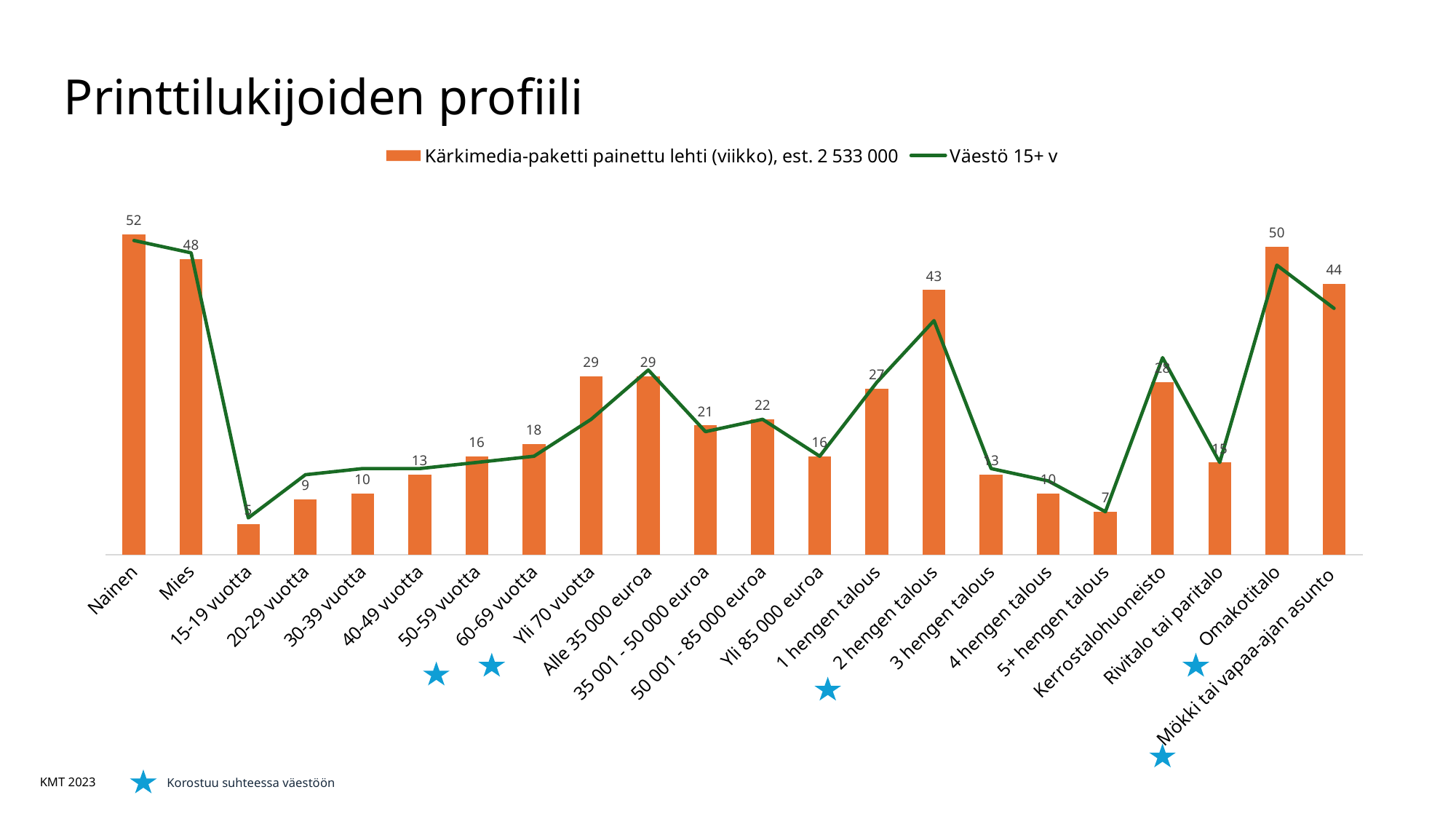
What is the value of the orange bar for 35 001 - 50 000 euroa? 21 How many categories are shown on the x axis? 22 What does the green line in the chart represent according to the legend? Väestö 15+ v What is the value of the orange bar for 2 hengen talous? 43 Do the orange bar values rise or fall across the age groups from 15-19 vuotta to Yli 70 vuotta? rise What is the value of the orange bar for Omakotitalo? 50 How many series does the legend list? 2 Which category has the lowest orange bar value? 15-19 vuotta Which has a larger orange bar value, 1 hengen talous or 3 hengen talous? 1 hengen talous What is the value of the orange bar for Nainen? 52 Which category has the highest orange bar value? Nainen What is the difference between the orange bar values for Omakotitalo and Mökki tai vapaa-ajan asunto? 6